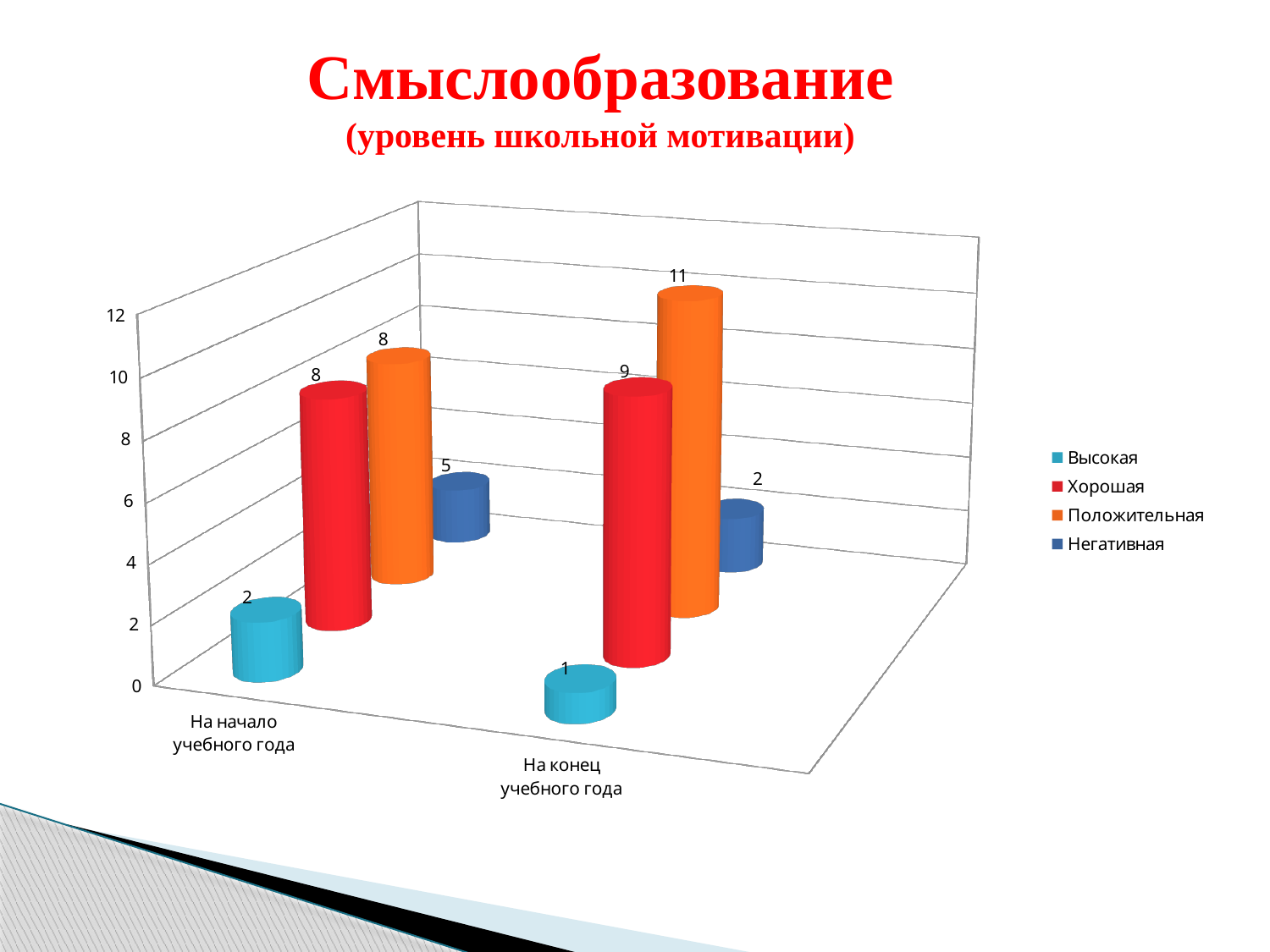
What kind of chart is shown on the slide? bar chart Which colour represents the Хорошая series? red What is the value for Положительная at На конец учебного года? 11 What is the value for Негативная at На начало учебного года? 5 How many categories are shown on the x axis? 2 Which series has the highest value at На конец учебного года? Положительная What is the value for Высокая at На конец учебного года? 1 Which is larger: Негативная at На начало учебного года or Негативная at На конец учебного года? На начало учебного года What is the difference between the Положительная values at На конец учебного года and На начало учебного года? 3 How many series does the legend list? 4 What is the value for Хорошая at На начало учебного года? 8 Which series has the lowest value at На начало учебного года? Высокая